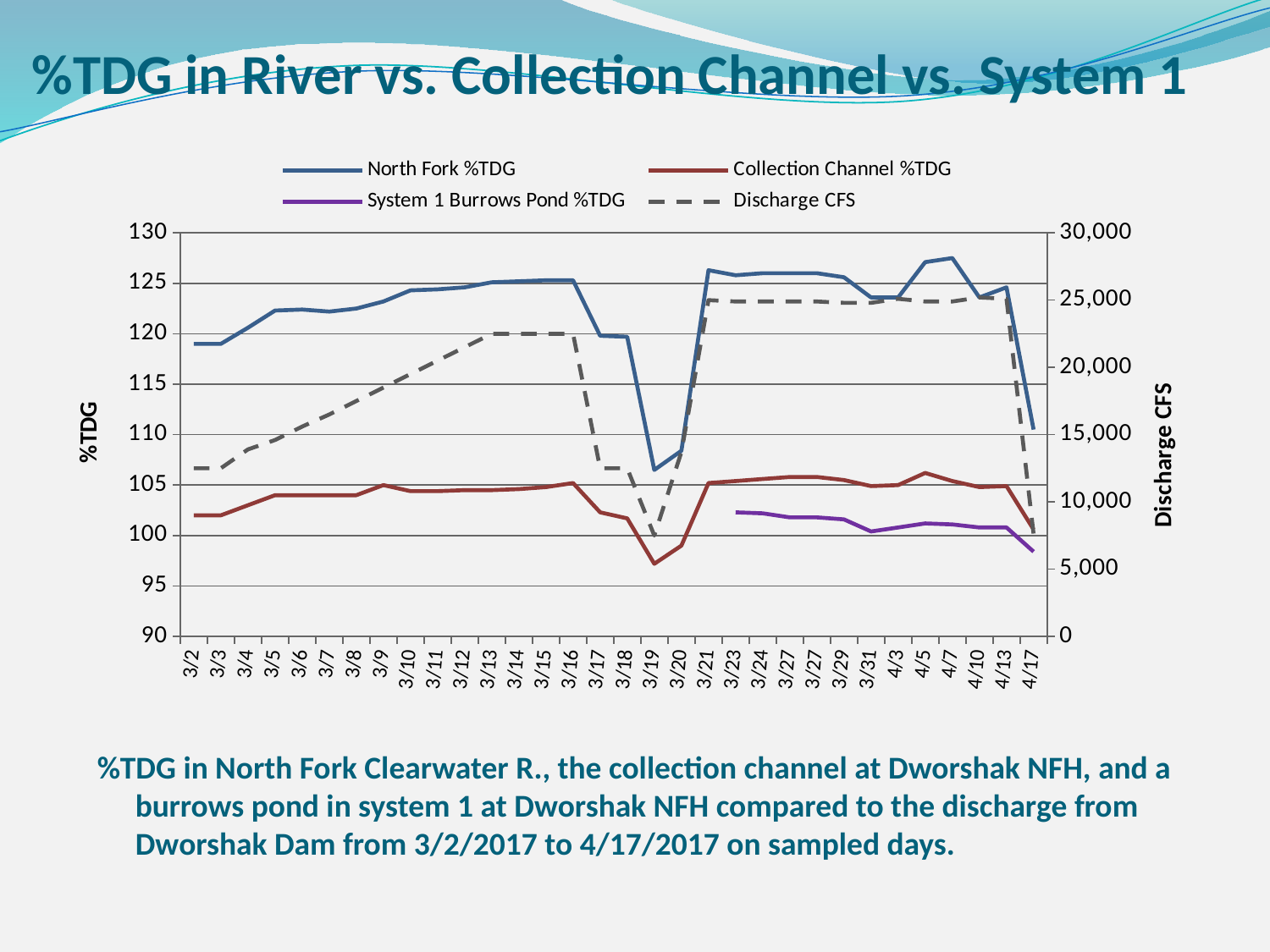
On which date is the Collection Channel %TDG value lowest? 3/19 Is the Collection Channel %TDG value on 3/19 greater or less than 100? less How many series does the legend list? 4 On 3/14, which is larger: North Fork %TDG or Collection Channel %TDG? North Fork %TDG Which series is drawn with a dashed line? Discharge CFS What kind of chart is shown on the slide? line chart Is the North Fork %TDG value on 3/19 greater or less than 110? less Is the Discharge CFS value on 3/21 greater or less than 20,000? greater On which date is the North Fork %TDG value lowest? 3/19 What is the title of the right-hand vertical axis? Discharge CFS Does the Discharge CFS value rise or fall from 3/2 to 3/13? rise